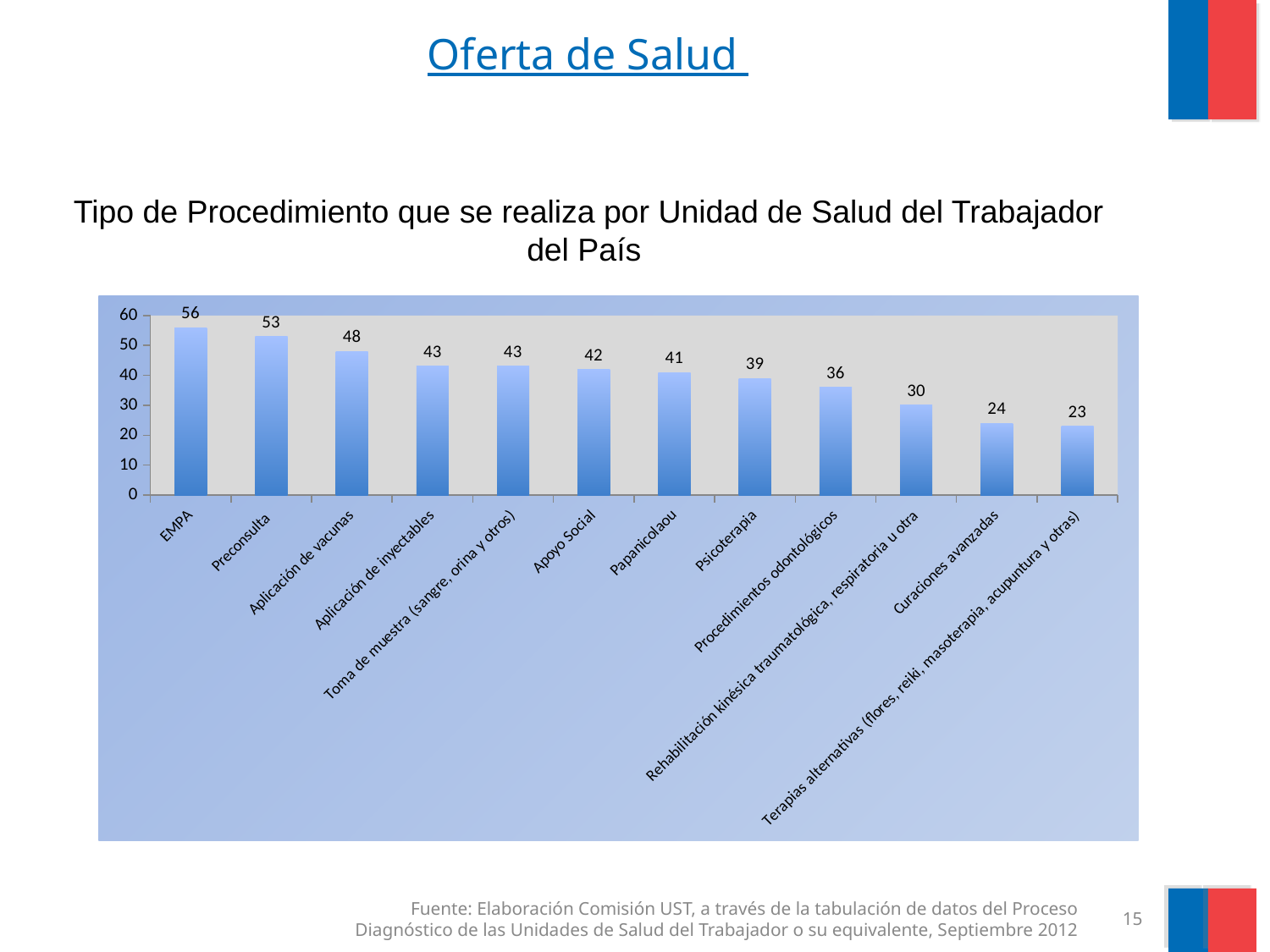
Which category has the lowest value? Terapias alternativas (flores, reiki, masoterapia, acupuntura y otras) What is the value for Psicoterapia? 39 Is the value for Procedimientos odontológicos greater or less than 40? less Which category has the highest value? EMPA What is the value for Curaciones avanzadas? 24 What is the title of the chart? Tipo de Procedimiento que se realiza por Unidad de Salud del Trabajador del País Do the values rise or fall from left to right along the x axis? fall What is the value for EMPA? 56 How many categories are shown in the chart? 12 What is the difference between the values for Preconsulta and Apoyo Social? 11 Which is larger, the value for Aplicación de vacunas or the value for Papanicolaou? Aplicación de vacunas What kind of chart is shown on the slide? bar chart